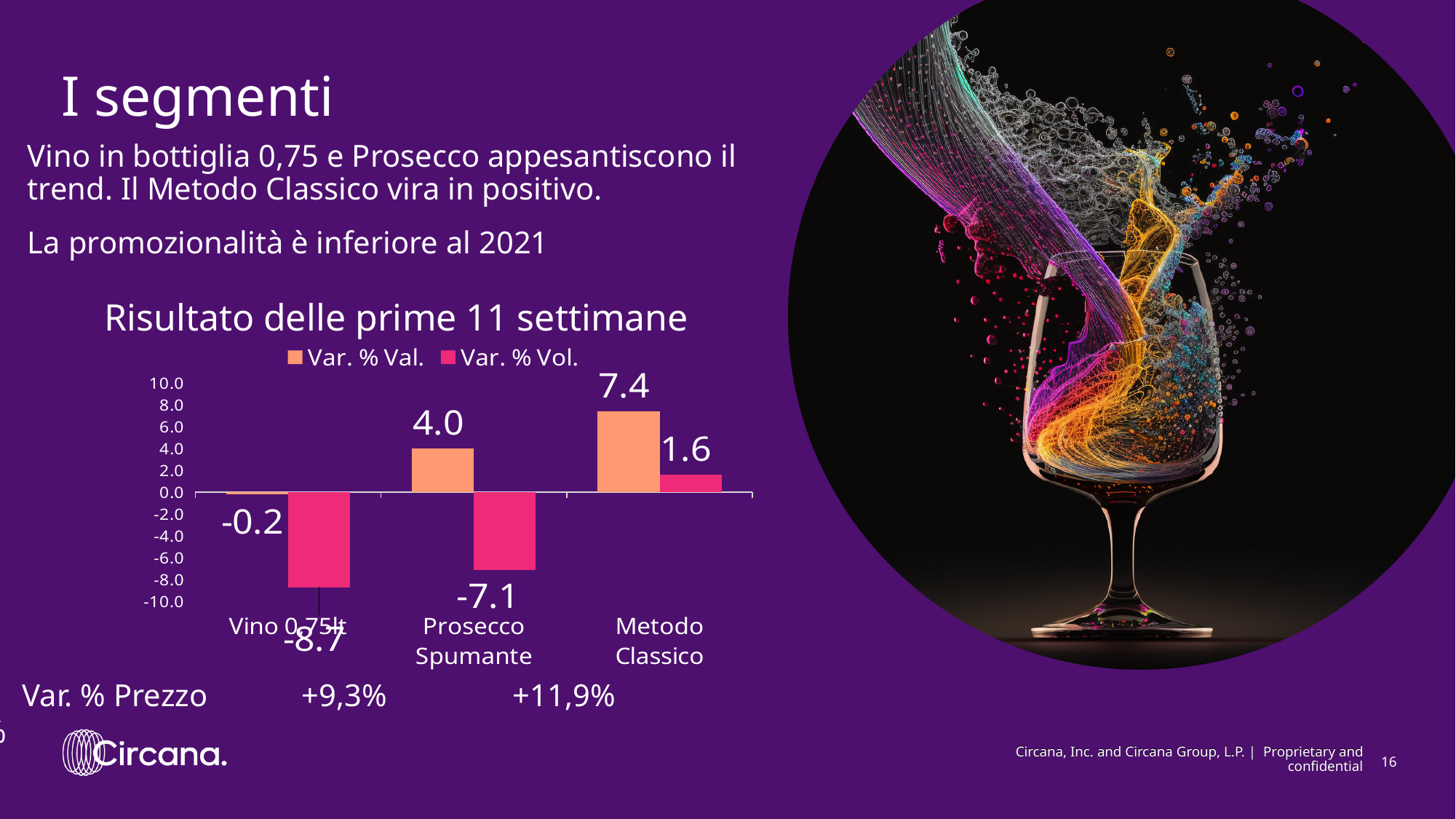
Which category has the highest Var. % Val. value? Metodo Classico What is the Var. % Val. value for Metodo Classico? 7.4 How many series does the chart legend list? 2 What is the title of the chart? Risultato delle prime 11 settimane Which category has the lowest Var. % Vol. value? Vino 0,75lt What is the Var. % Val. value for Prosecco Spumante? 4.0 What type of chart is shown on the slide? Bar chart How many categories are shown on the x axis of the chart? 3 What is the difference between the Var. % Val. and Var. % Vol. values for Metodo Classico? 5.8 Which is larger, the Var. % Vol. value for Prosecco Spumante or for Metodo Classico? Metodo Classico What is the Var. % Vol. value for Prosecco Spumante? -7.1 What is the Var. % Vol. value for Vino 0,75lt? -8.7